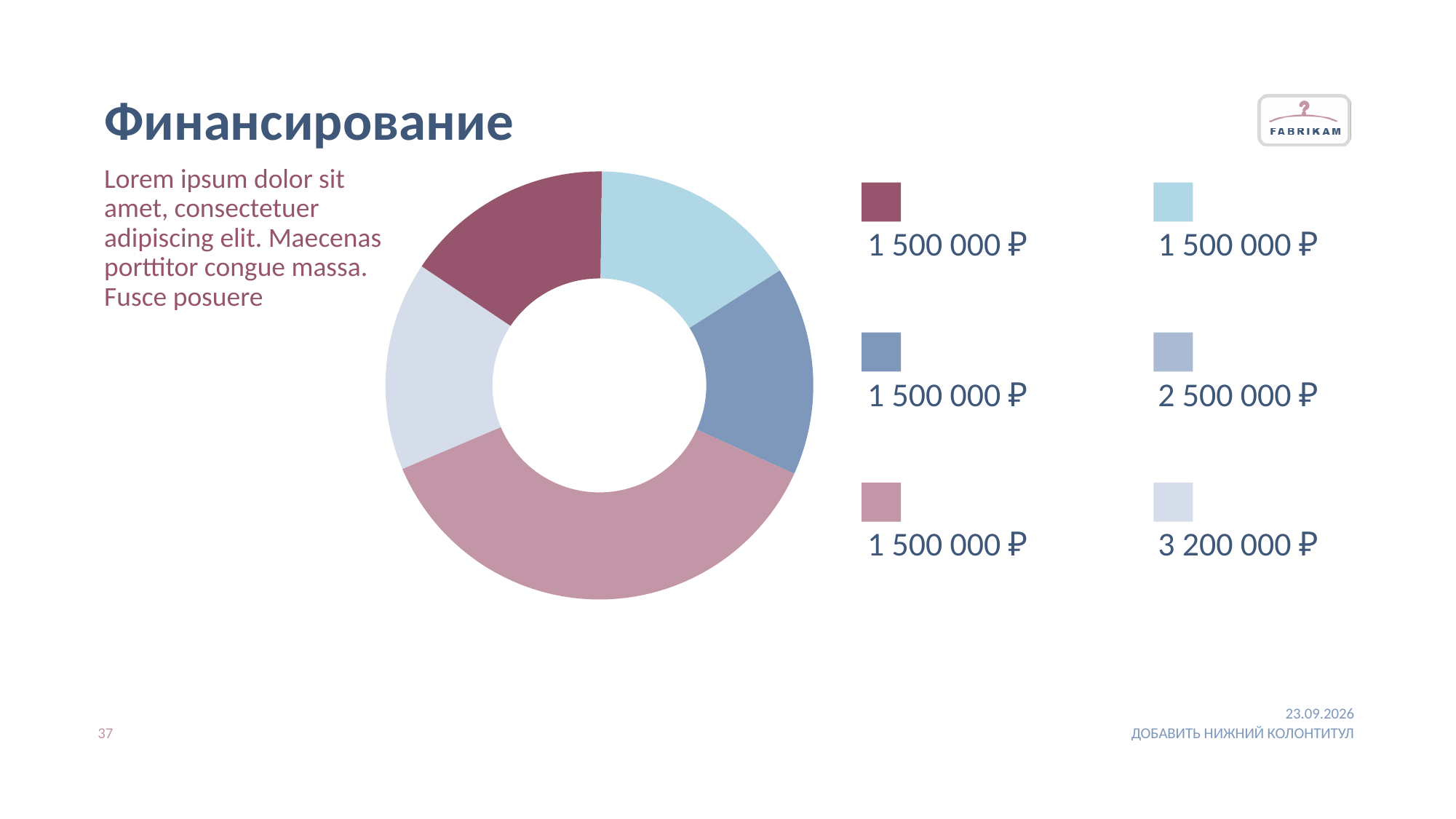
What value is shown next to the dark red legend square? 1 500 000 ₽ What is the largest value listed in the legend? 3 200 000 ₽ What value is shown next to the light blue legend square? 1 500 000 ₽ Which colour slice is the largest in the donut chart? pink Which is larger: the grey-blue legend value or the light grey legend value? the light grey value, 3 200 000 ₽ What value is shown next to the light grey legend square? 3 200 000 ₽ What value is shown next to the grey-blue legend square (middle right)? 2 500 000 ₽ What is the smallest value listed in the legend? 1 500 000 ₽ How many values are listed in the legend? 6 What is the difference between the light grey legend value and the grey-blue legend value? 700 000 ₽ What kind of chart is shown on the slide? donut chart